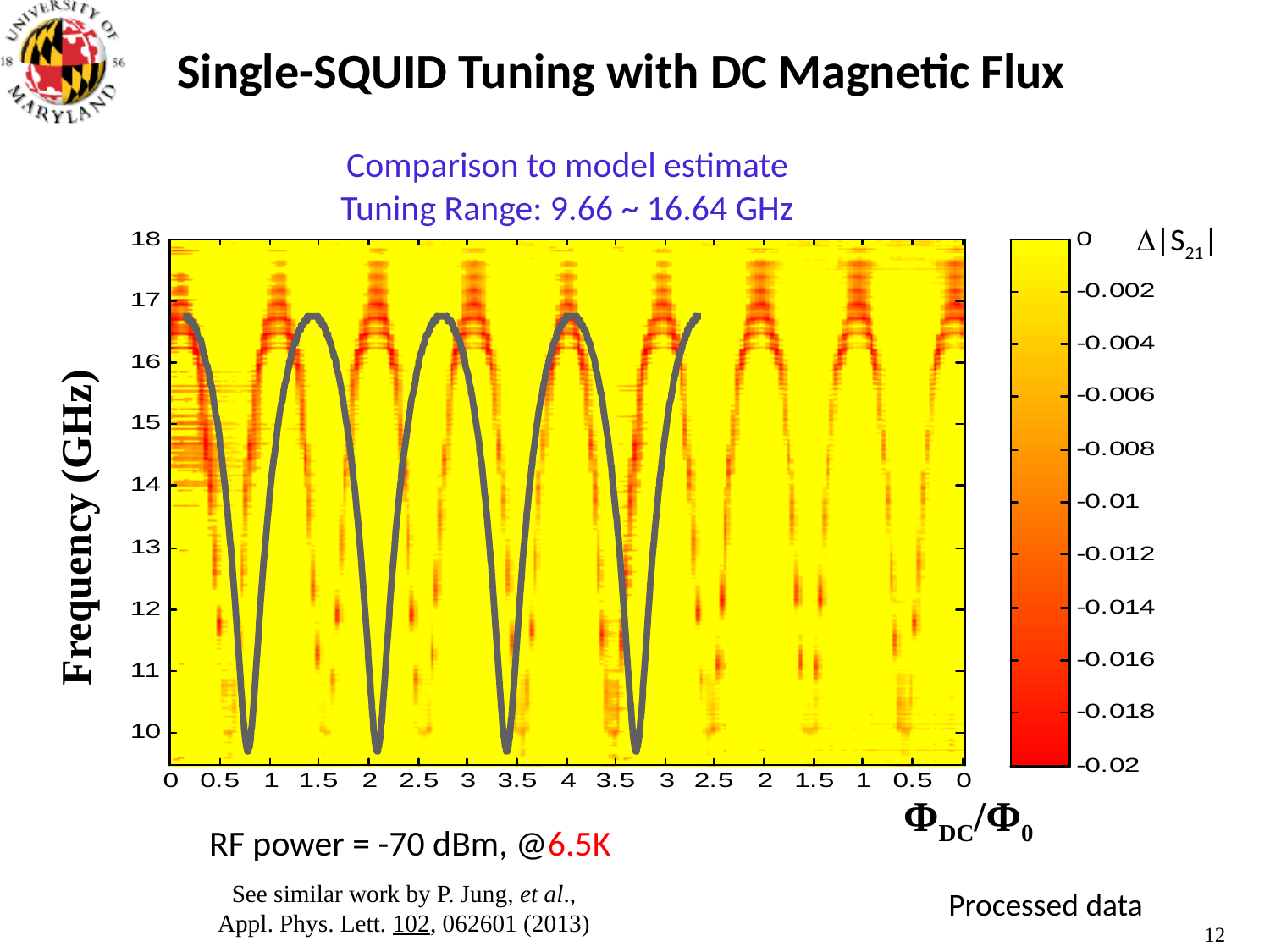
Is the minimum frequency reached by the gray model curve greater or less than 10 GHz? less What is the lowest value shown on the color bar scale? -0.02 What quantity does the color bar to the right of the chart represent? Δ|S21| What tuning range is stated above the chart? 9.66 ~ 16.64 GHz What kind of chart is shown on the slide? Heatmap (color map) What is the lowest frequency tick shown on the vertical axis? 10 Is the maximum frequency reached by the gray model curve greater or less than 17 GHz? less What is the highest value shown on the color bar scale? 0 What is the label of the vertical axis of the chart? Frequency (GHz) How many minima (dips) does the gray model curve have? 4 What is the largest value of Φ_DC/Φ_0 labeled on the horizontal axis? 4 What is the highest frequency tick shown on the vertical axis? 18